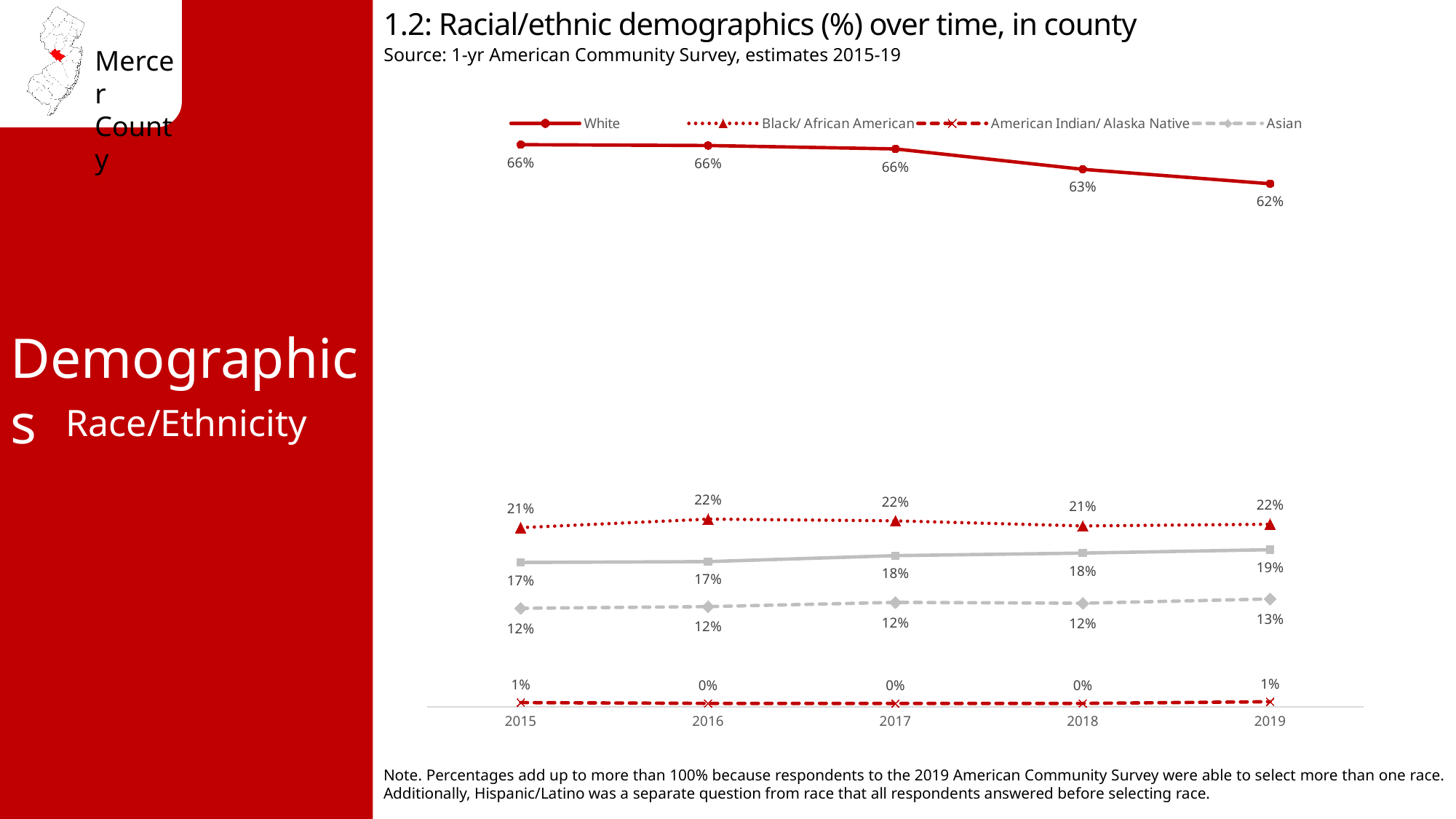
By how many percentage points did the White share change from 2015 to 2019? 4 percentage points What is the value for American Indian/ Alaska Native in 2017? 0% How many series does the legend list? 4 What is the value for Asian in 2019? 13% How many years are shown on the x axis? 5 What is the value for Black/ African American in 2016? 22% In 2019, which is larger: the Black/ African American share or the Asian share? Black/ African American What kind of chart is shown on the slide? Line chart Does the White share rise or fall from 2015 to 2019? Fall What is the value for White in 2019? 62% What is the value for White in 2018? 63% Which series has the highest value in 2019? White